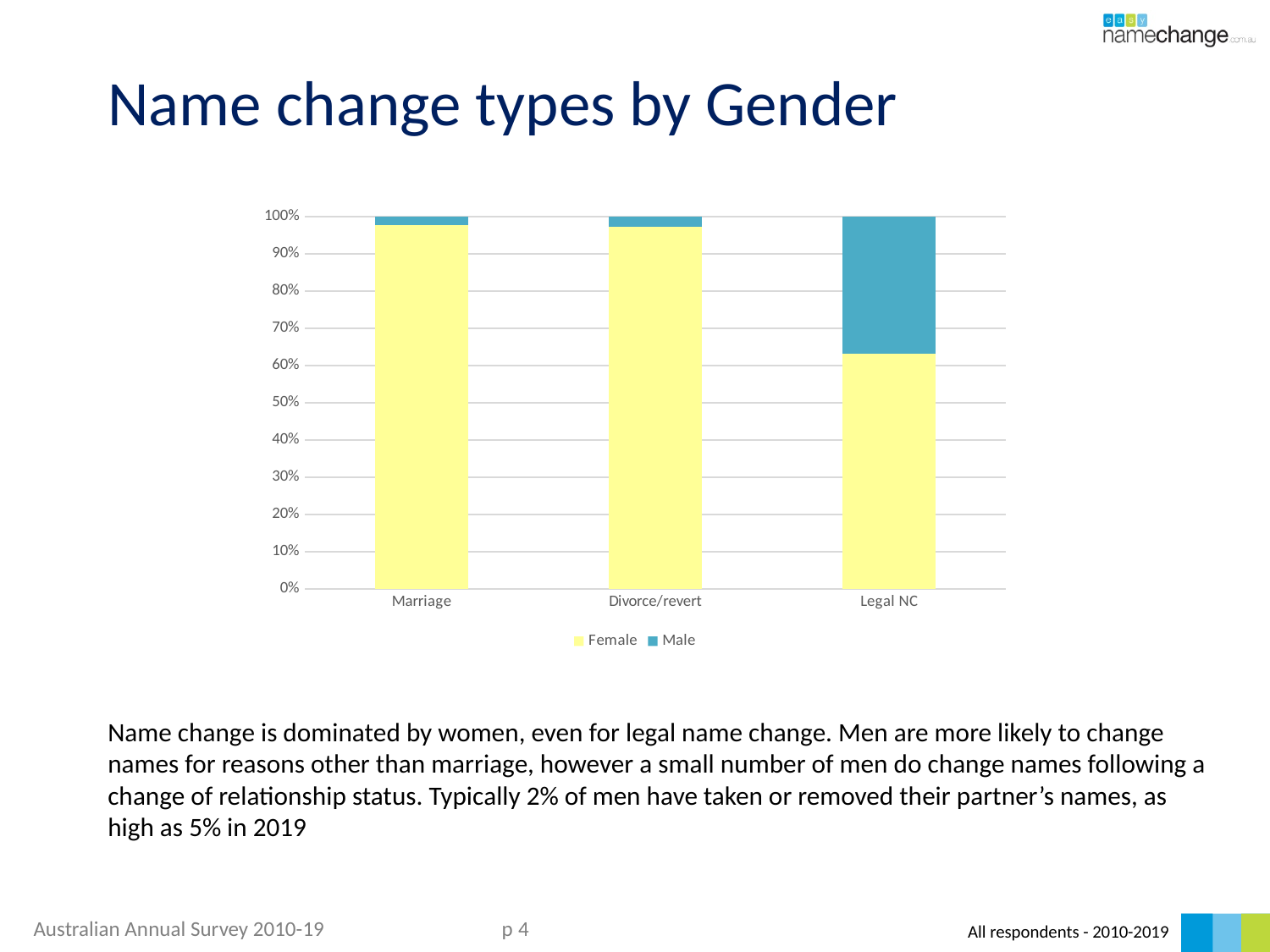
How many name change types (categories) are shown on the x axis? 3 Which is larger, the Female share for Marriage or the Female share for Legal NC? Marriage Is the Female share for Marriage greater or less than 90%? greater What is the title of the chart on the slide? Name change types by Gender Which category has the lowest Female share? Legal NC Which colour represents the Male series in the chart? blue Which category has the highest Male share? Legal NC Is the Female share for Legal NC greater or less than 70%? less What kind of chart is shown on the slide? stacked bar chart Is the Female share for Legal NC greater or less than 50%? greater How many series does the legend list? 2